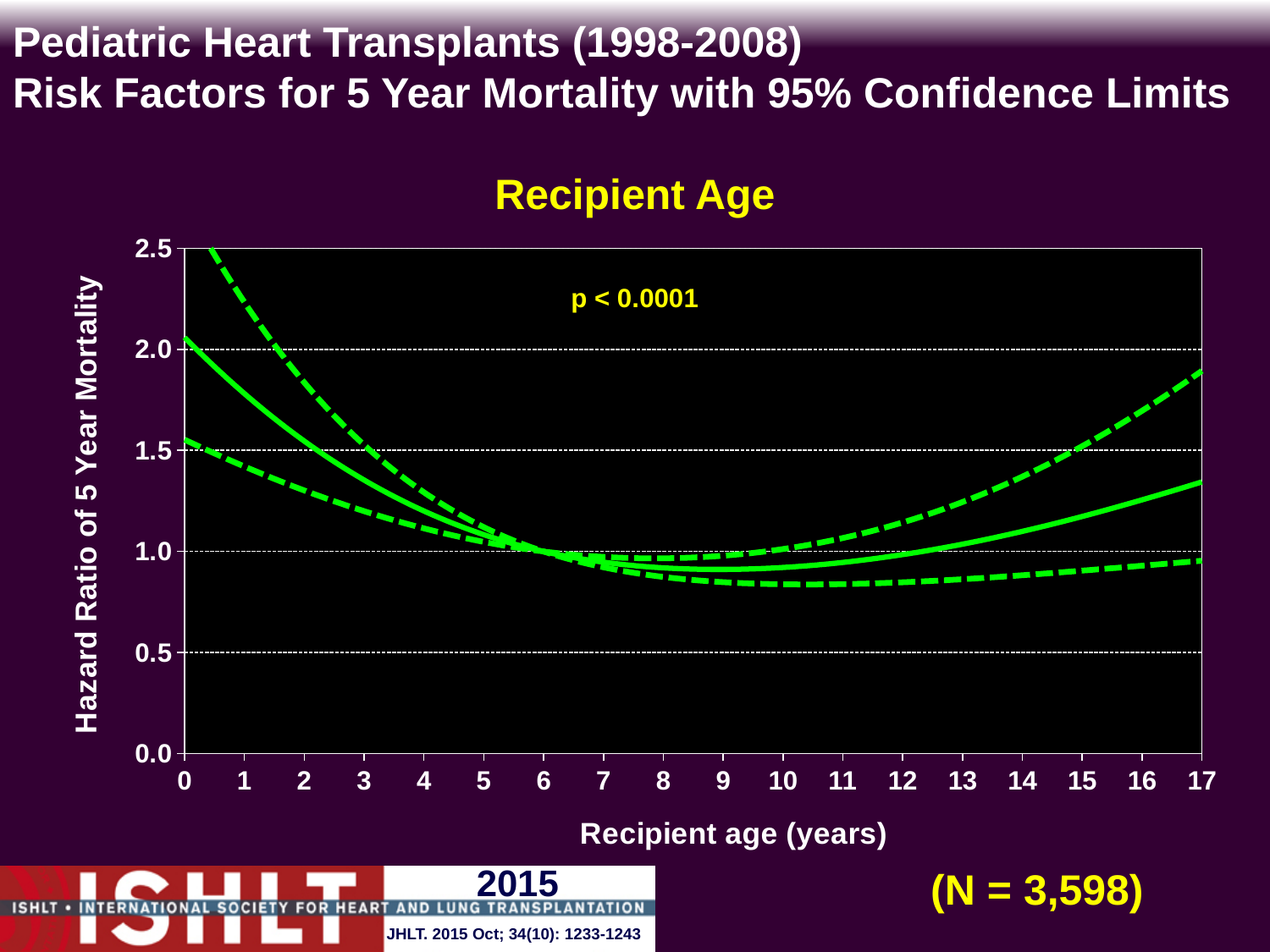
What is the label of the y axis? Hazard Ratio of 5 Year Mortality Does the solid line rise or fall as recipient age increases from 0 to 9 years? fall How many lines are plotted on the chart? 3 Is the value of the solid line at recipient age 0 greater or less than 1.5? greater Does the solid line rise or fall as recipient age increases from 9 to 17 years? rise Which is larger for the solid line: the value at recipient age 0 or at recipient age 17? recipient age 0 Is the value of the solid line at recipient age 17 greater or less than 1.5? less Is the value of the upper dashed line at recipient age 17 greater or less than 1.5? greater What kind of chart is shown on the slide? line chart What is the title of the chart? Recipient Age